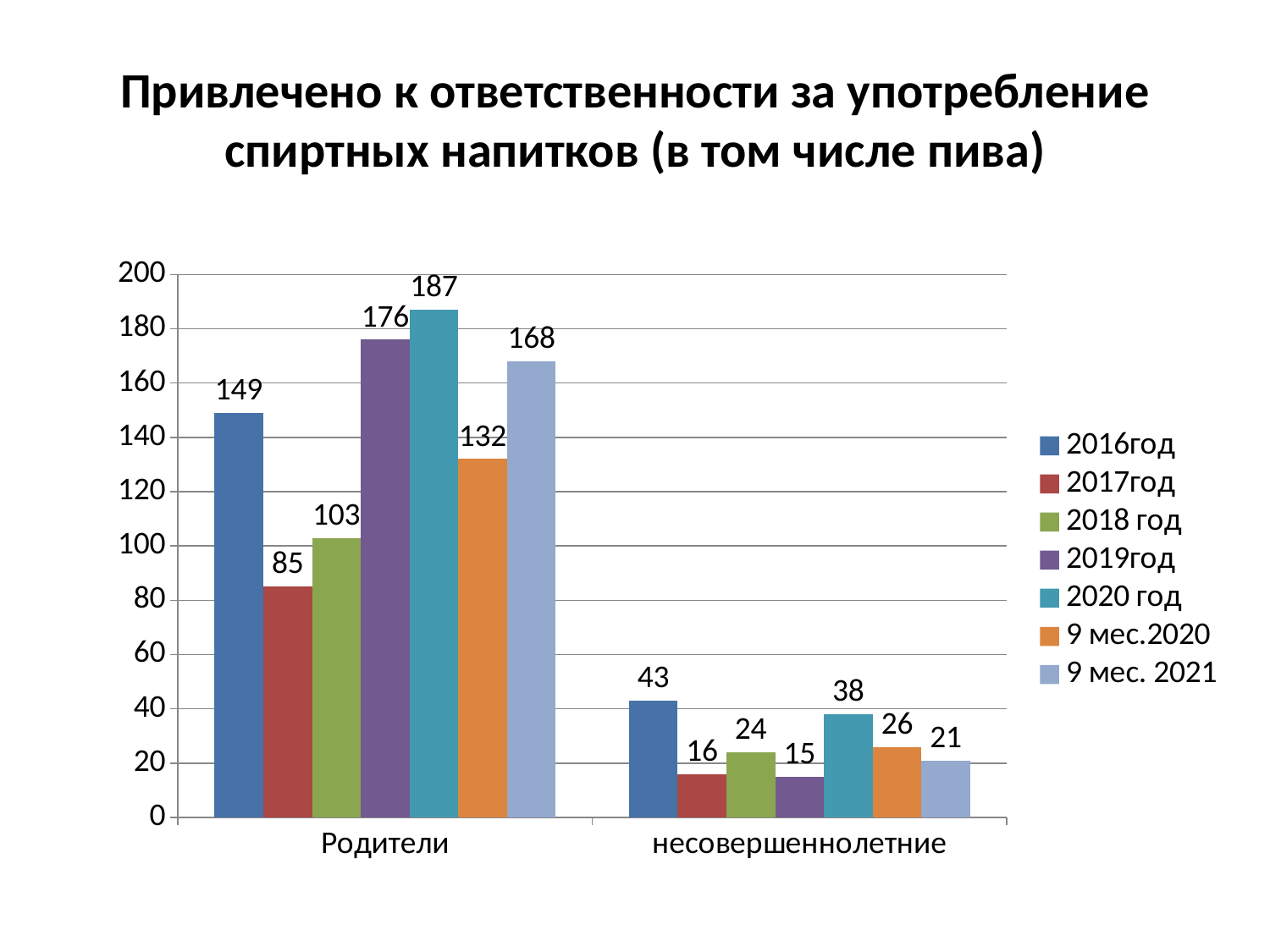
What is the value for Родители in the 9 мес. 2021 series? 168 How many series does the legend list? 7 Which series has the lowest value for несовершеннолетние? 2019год What is the difference between the 9 мес.2020 and 9 мес. 2021 values for несовершеннолетние? 5 What is the difference between the 2020 год and 2019год values for Родители? 11 How many categories are shown on the x axis? 2 Which series has the highest value for Родители? 2020 год Which is larger for Родители: the 2016год value or the 9 мес.2020 value? 2016год What is the value for несовершеннолетние in the 2017год series? 16 What is the value for Родители in the 2020 год series? 187 What kind of chart is shown on the slide? bar chart What is the title of the chart? Привлечено к ответственности за употребление спиртных напитков (в том числе пива)